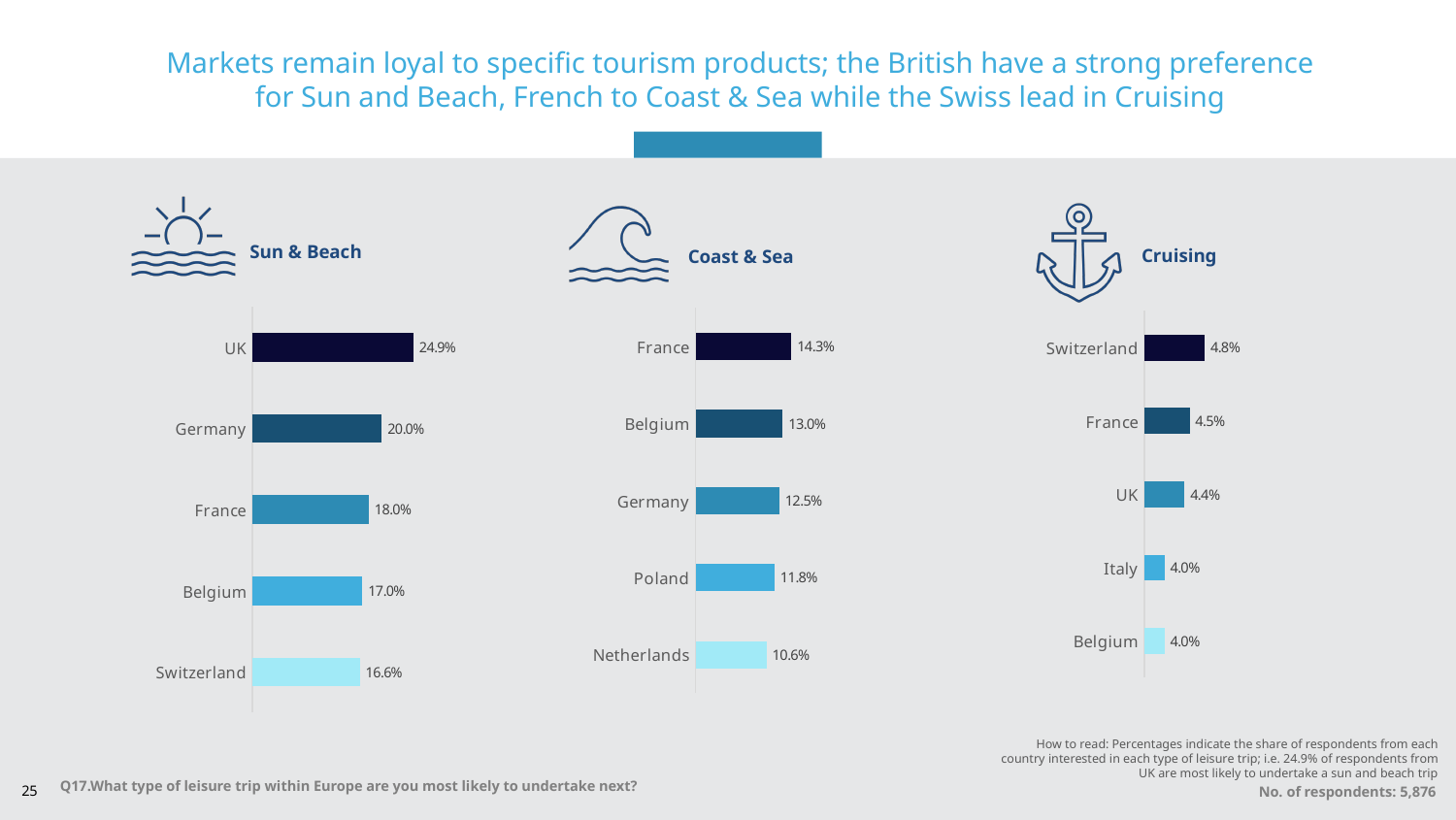
In the Cruising chart, what is the value for the UK? 4.4% In the Sun & Beach chart, what is the value for Germany? 20.0% In the Coast & Sea chart, which country has the lowest value? Netherlands In the Sun & Beach chart, which is larger, the value for France or the value for Belgium? France In the Cruising chart, which country has the highest value? Switzerland What type of chart is the Cruising chart? Bar chart In the Sun & Beach chart, what is the difference between the values for UK and Switzerland? 8.3% How many countries are shown in the Coast & Sea chart? 5 In the Coast & Sea chart, what is the value for Poland? 11.8% In the Coast & Sea chart, what is the difference between the values for France and Belgium? 1.3% In the Sun & Beach chart, which country has the highest value? UK What is the title of the chart on the left of the slide? Sun & Beach